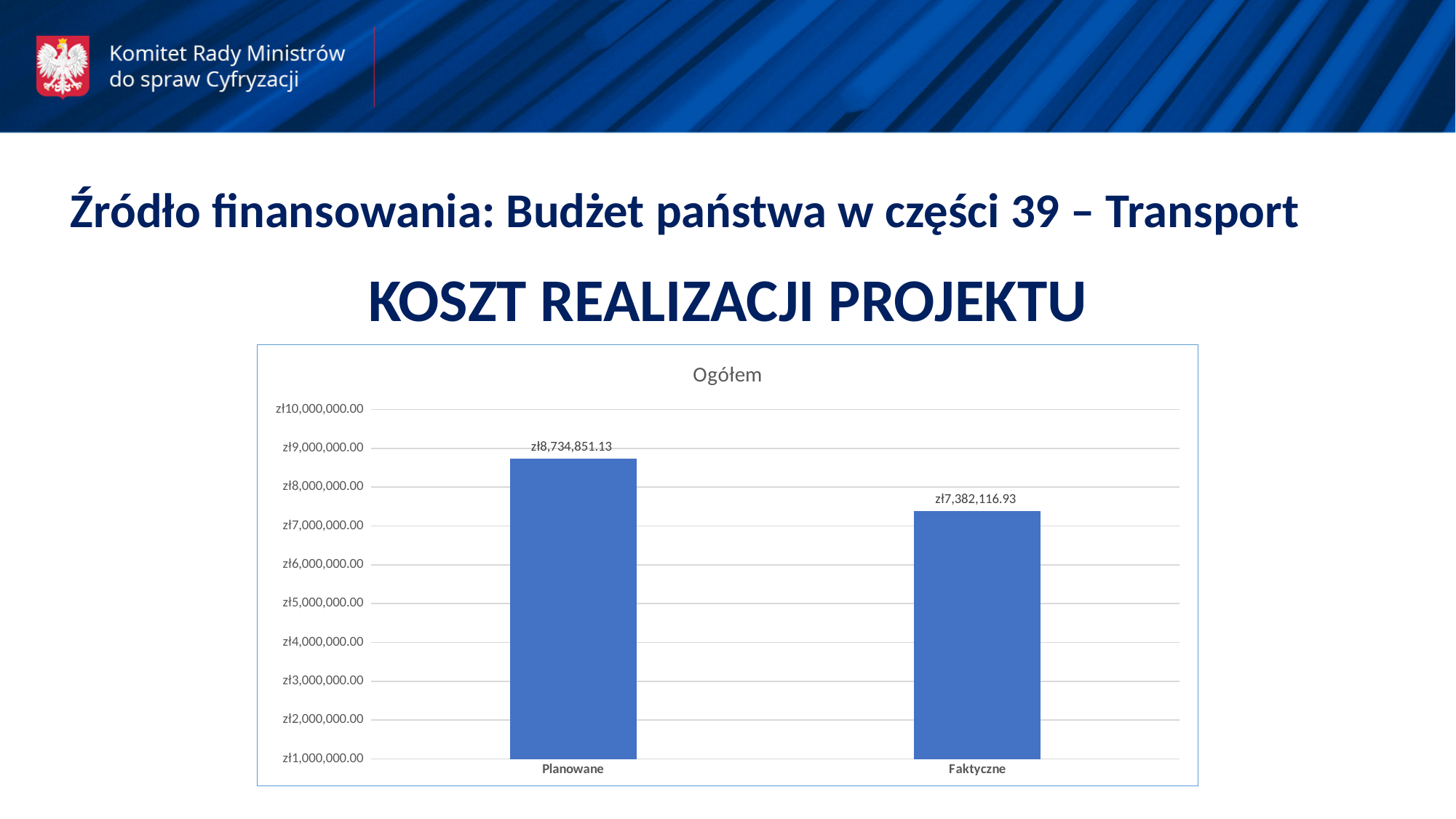
What is the difference between the Planowane and Faktyczne values? zł1,352,734.20 What type of chart is shown on the slide? bar chart Which category has the lower value? Faktyczne Is the value for Faktyczne greater or less than zł8,000,000.00? less What is the highest value shown on the vertical axis? zł10,000,000.00 What is the value of the Faktyczne bar? zł7,382,116.93 Which category has the higher value? Planowane What is the value of the Planowane bar? zł8,734,851.13 Is the value for Planowane greater or less than zł8,000,000.00? greater How many bars are shown in the chart? 2 Is the value for Planowane larger or smaller than the value for Faktyczne? larger What is the title of the chart? Ogółem